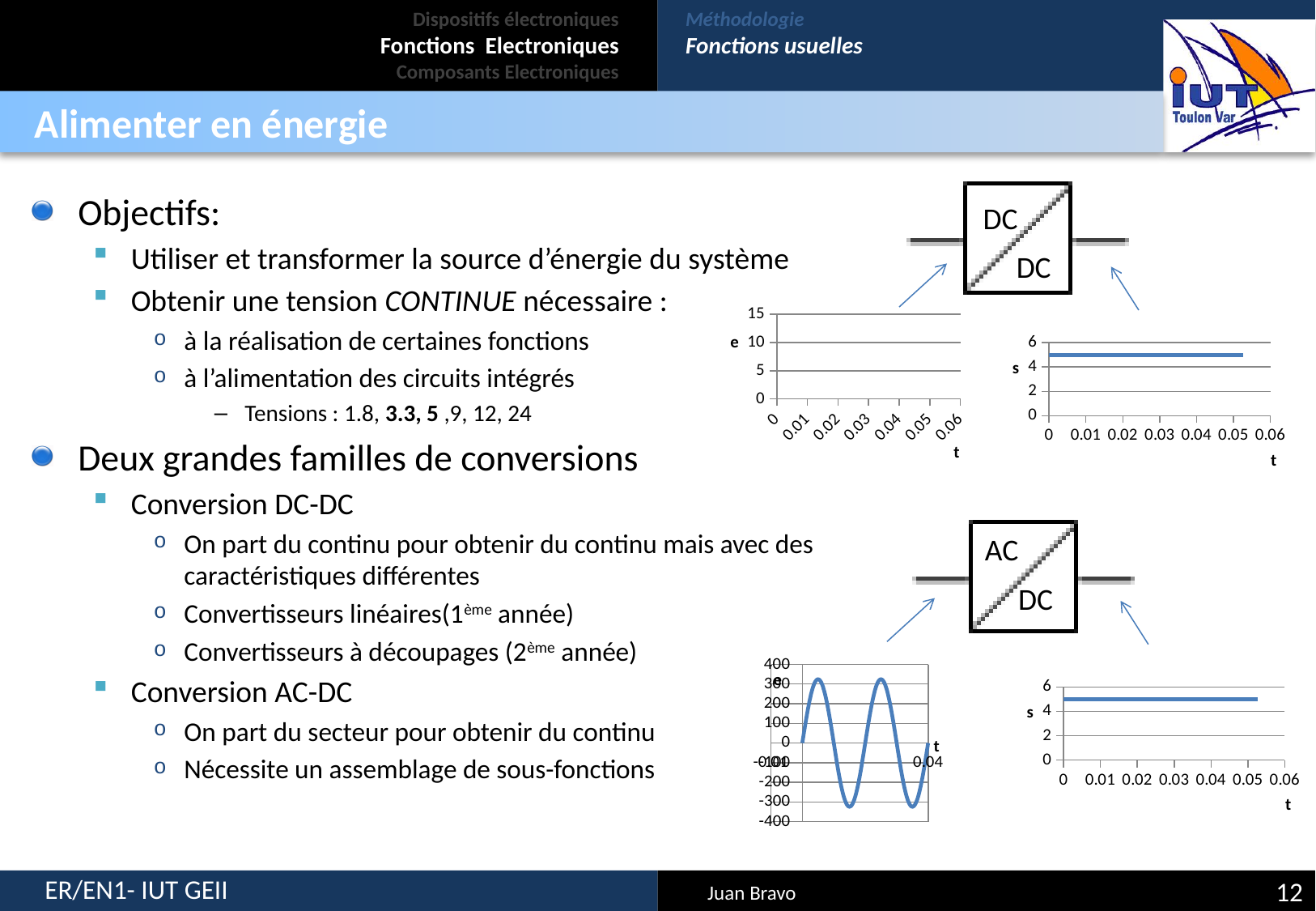
In the bottom-left chart (labelled e), does the plotted line rise steadily, fall steadily, or oscillate along the t axis? oscillate In the top-right chart (labelled s), is the plotted value greater or less than 6? less In the bottom-right chart (labelled s), does the plotted line rise, fall, or stay constant along the t axis? stay constant What kind of chart is the bottom-left chart (the one labelled e with values from -400 to 400)? line chart What is the highest tick value on the vertical axis of the top-left chart (labelled e)? 15 What kind of chart is the bottom-right chart (labelled s)? line chart In the top-right chart (labelled s), is the plotted value greater or less than 4? greater In the bottom-left chart (labelled e), what is the lowest value shown on the vertical axis? -400 In the top-right chart (labelled s), does the plotted line rise, fall, or stay constant along the t axis? stay constant In the bottom-right chart (labelled s), is the plotted value greater or less than 2? greater In the bottom-left chart (labelled e), what is the highest value shown on the vertical axis? 400